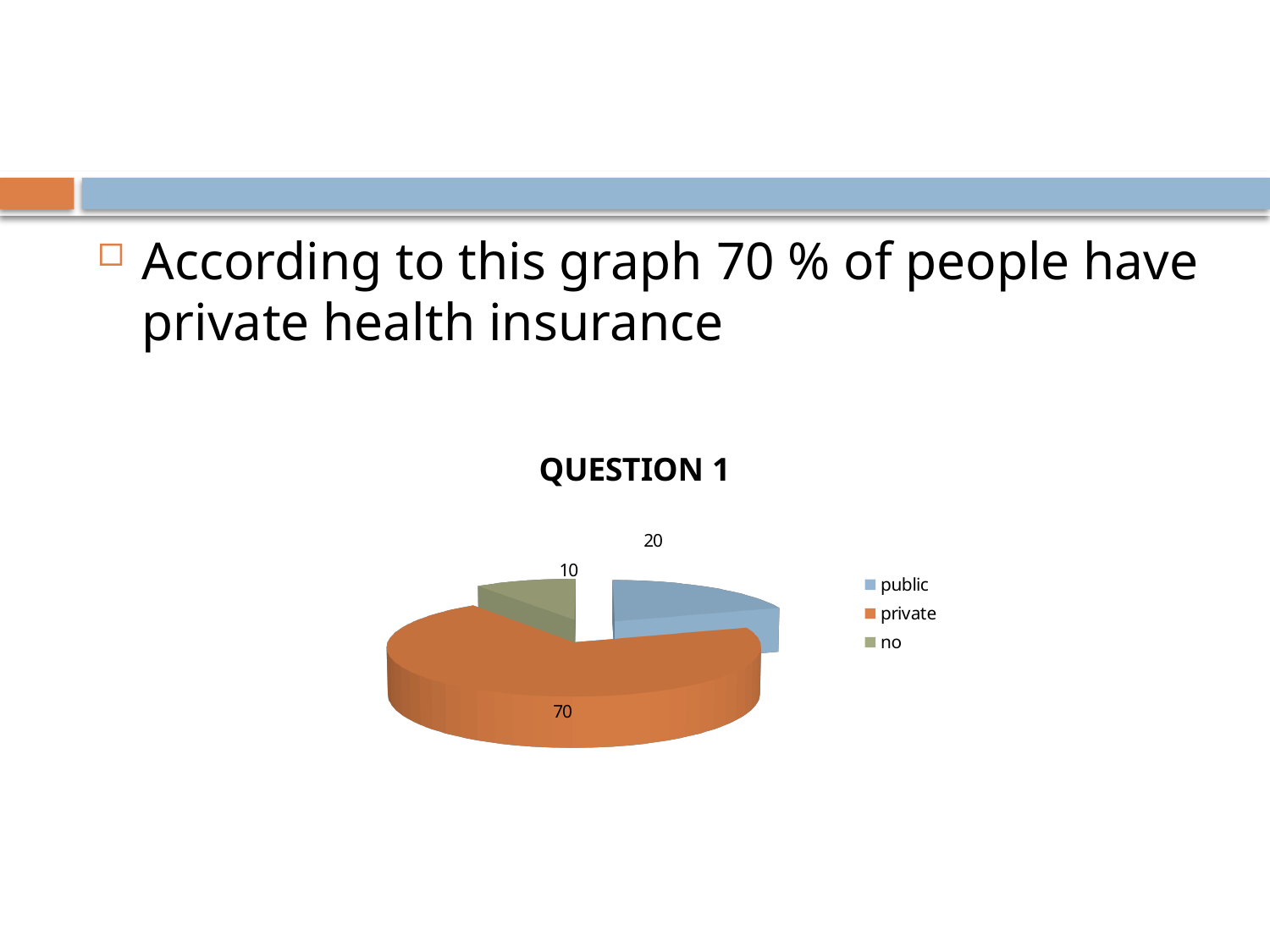
What kind of chart is shown? pie chart What is the value for no? 10 What is the value for private? 70 What share of the pie does the private slice represent? 70% Which category has the largest slice? private Which is larger, the value for public or the value for no? public What is the value for public? 20 How many entries does the legend list? 3 What is the difference between the values for private and public? 50 How many slices does the pie chart have? 3 What is the title of the chart? QUESTION 1 Which category has the smallest slice? no